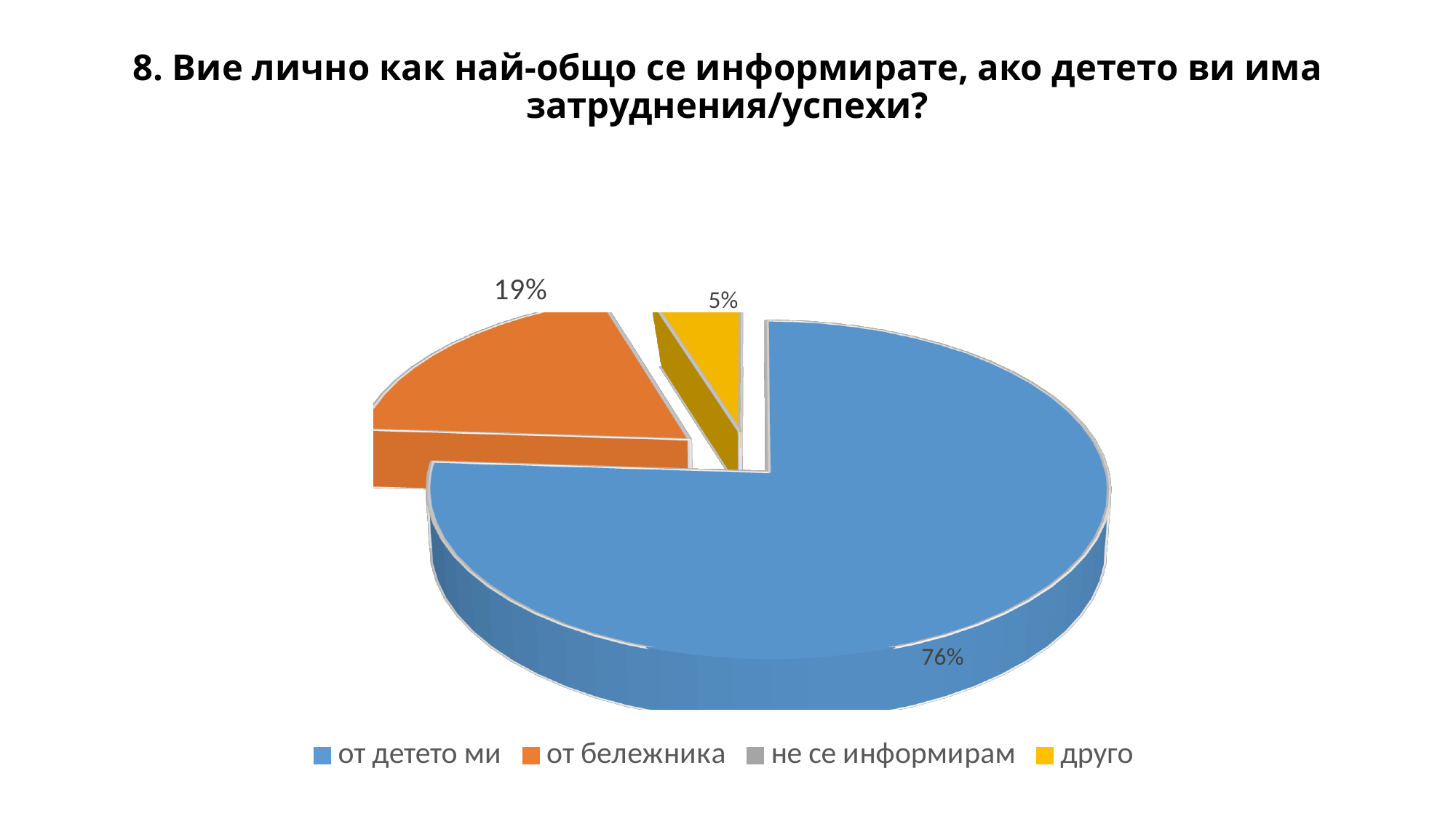
What is the difference in percentage points between "от бележника" and "друго"? 14 What percentage of the pie is labelled for "от детето ми"? 76% What percentage of the pie is labelled for "друго"? 5% Which category has the largest slice of the pie? от детето ми How many entries does the legend list? 4 What percentage of the pie is labelled for "от бележника"? 19% What is the difference in percentage points between "от детето ми" and "от бележника"? 57 What kind of chart is shown on the slide? Pie chart Which is larger, the slice for "от бележника" or the slice for "друго"? от бележника Which legend entry is shown in orange? от бележника What colour is the slice for "от детето ми"? Blue